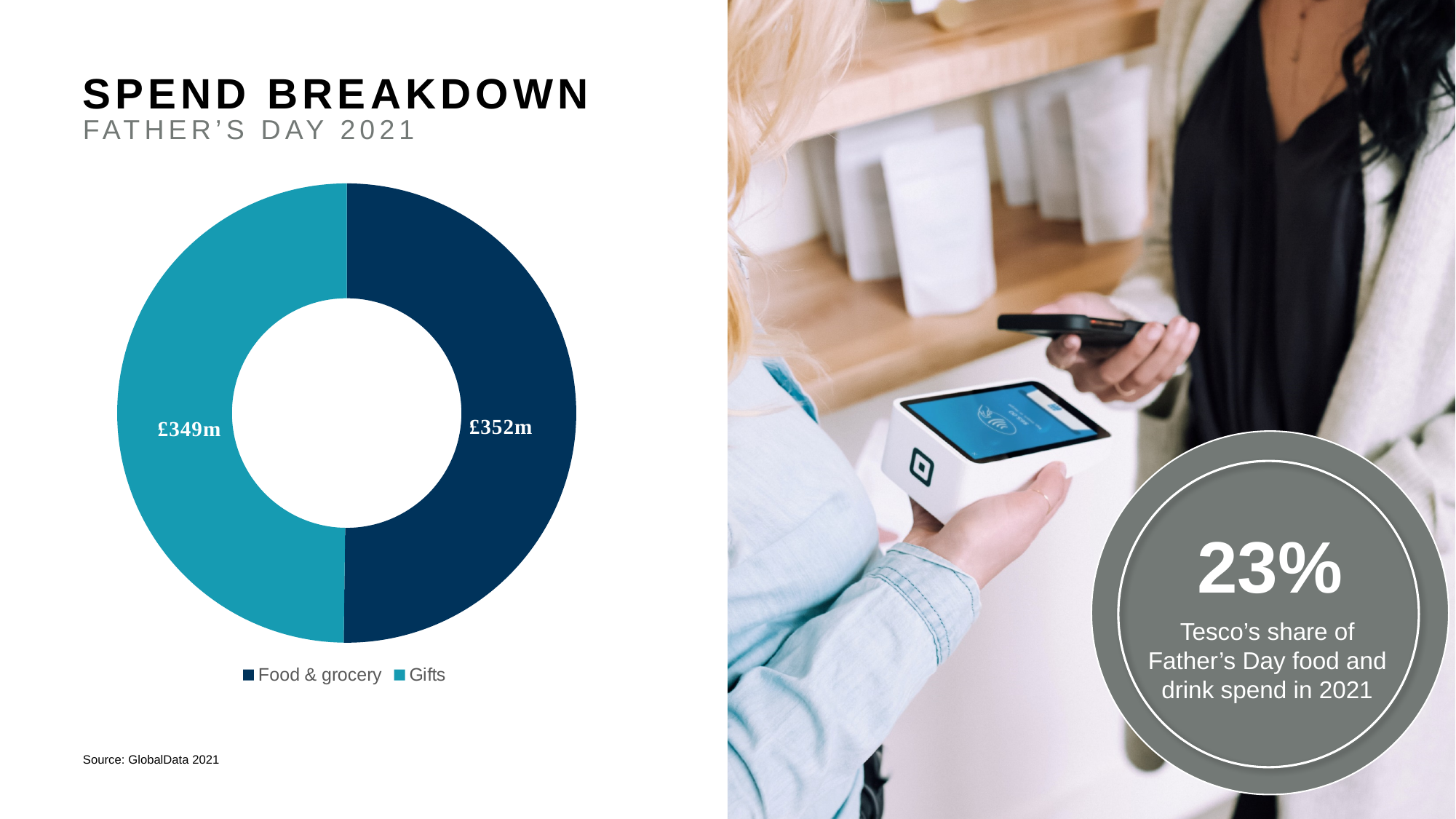
What is the combined total of the two slices in the Spend Breakdown chart? £701m Which category has the larger value in the Spend Breakdown chart? Food & grocery What is the subtitle under the chart title 'Spend Breakdown'? Father's Day 2021 What is the difference between the Food & grocery and Gifts values in the Spend Breakdown chart? £3m What kind of chart is used for the Spend Breakdown? Pie chart (donut) How many entries does the legend of the Spend Breakdown chart list? 2 Which colour represents Gifts in the Spend Breakdown chart? Teal (light blue) Which category has the smaller value in the Spend Breakdown chart? Gifts How many categories are shown in the Spend Breakdown chart? 2 What is the value for Food & grocery in the Spend Breakdown chart? £352m What is the value for Gifts in the Spend Breakdown chart? £349m Is the value for Food & grocery larger or smaller than the value for Gifts? larger